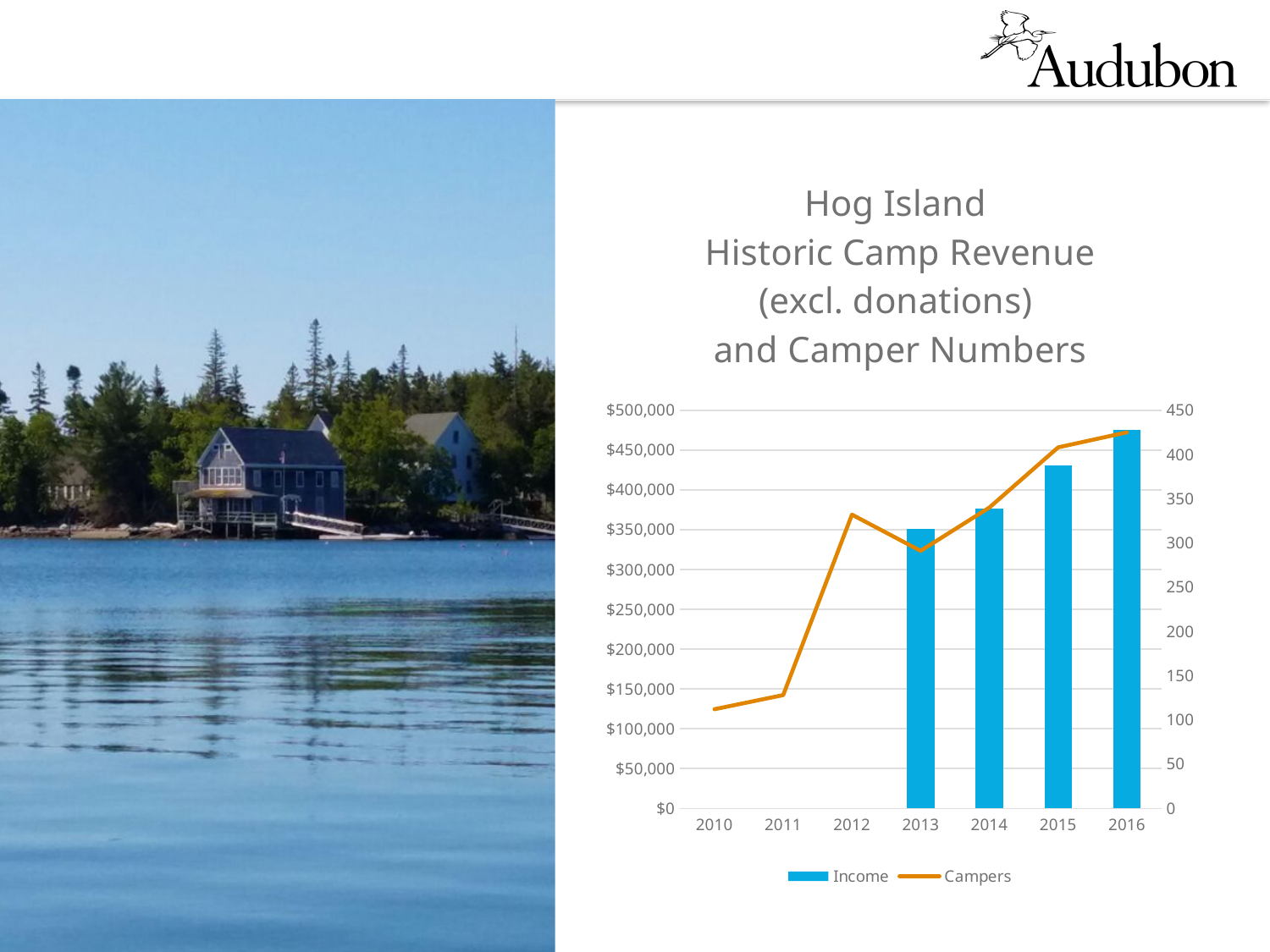
How many series does the legend list? 2 Which year has the larger Income, 2014 or 2015? 2015 Is the Income value for 2013 greater or less than $400,000? less What kind of chart is shown on the slide? A combination bar and line chart Do the Income bars rise or fall from 2013 to 2016? rise Is the Campers value for 2015 greater or less than 350? greater Is the Income value for 2016 greater or less than $450,000? greater How many years are shown on the x axis? 7 Which year has the lowest Income bar among the years with bars? 2013 Which year has the lowest number of Campers? 2010 Which year has the highest Income bar? 2016